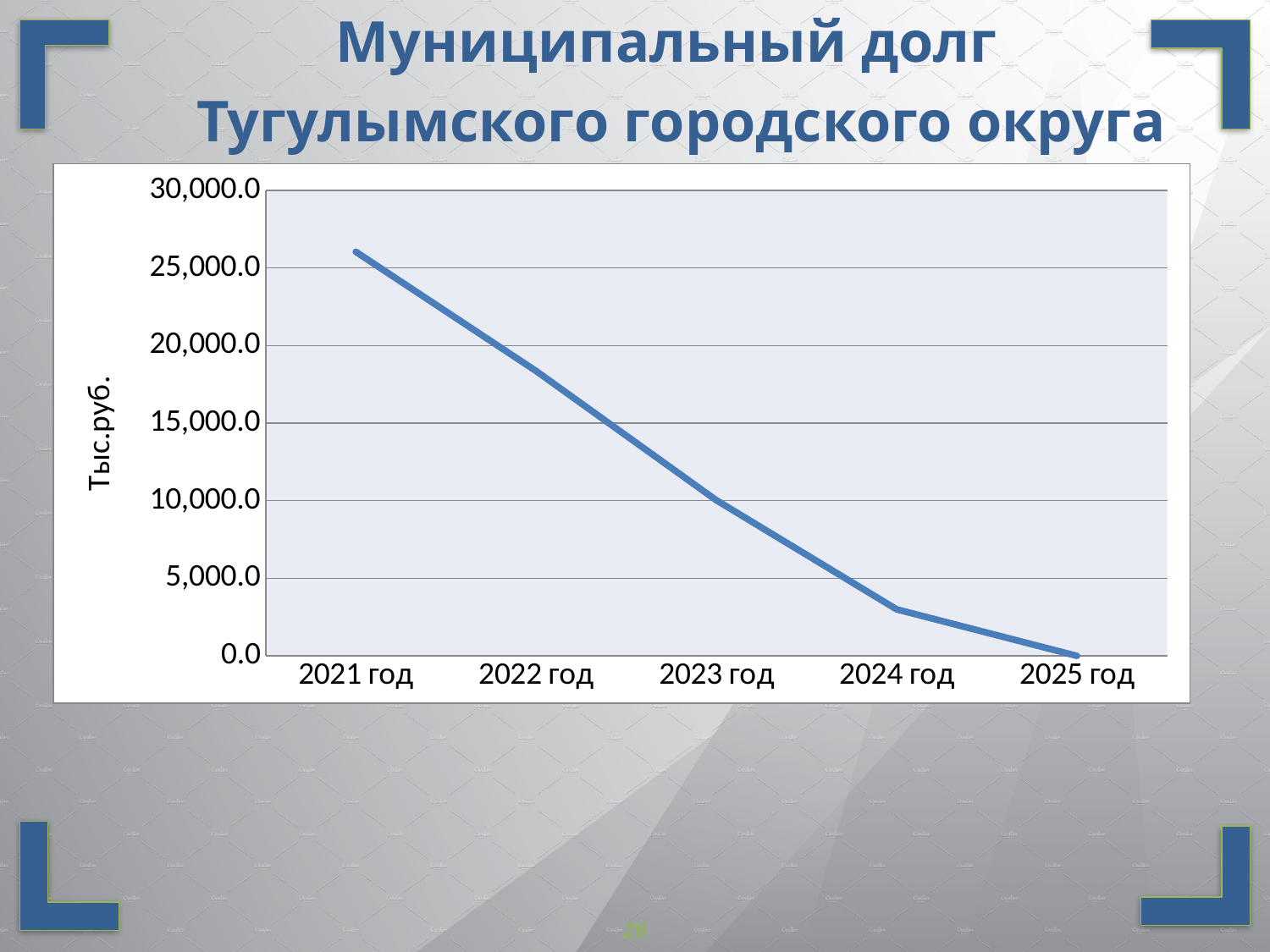
What is the title of the slide containing the chart? Муниципальный долг Тугулымского городского округа Do the values rise or fall from 2021 год to 2025 год? fall Is the value for 2022 год greater or less than 20,000.0? less Which is larger, the value for 2022 год or the value for 2024 год? 2022 год Is the value for 2021 год greater or less than 25,000.0? greater Which year has the highest municipal debt value on the chart? 2021 год Is the value for 2023 год greater or less than 15,000.0? less Which year has the lowest municipal debt value on the chart? 2025 год What kind of chart is shown on the slide? line chart How many years are plotted on the x axis of the chart? 5 What is the unit label on the vertical axis of the chart? Тыс.руб.